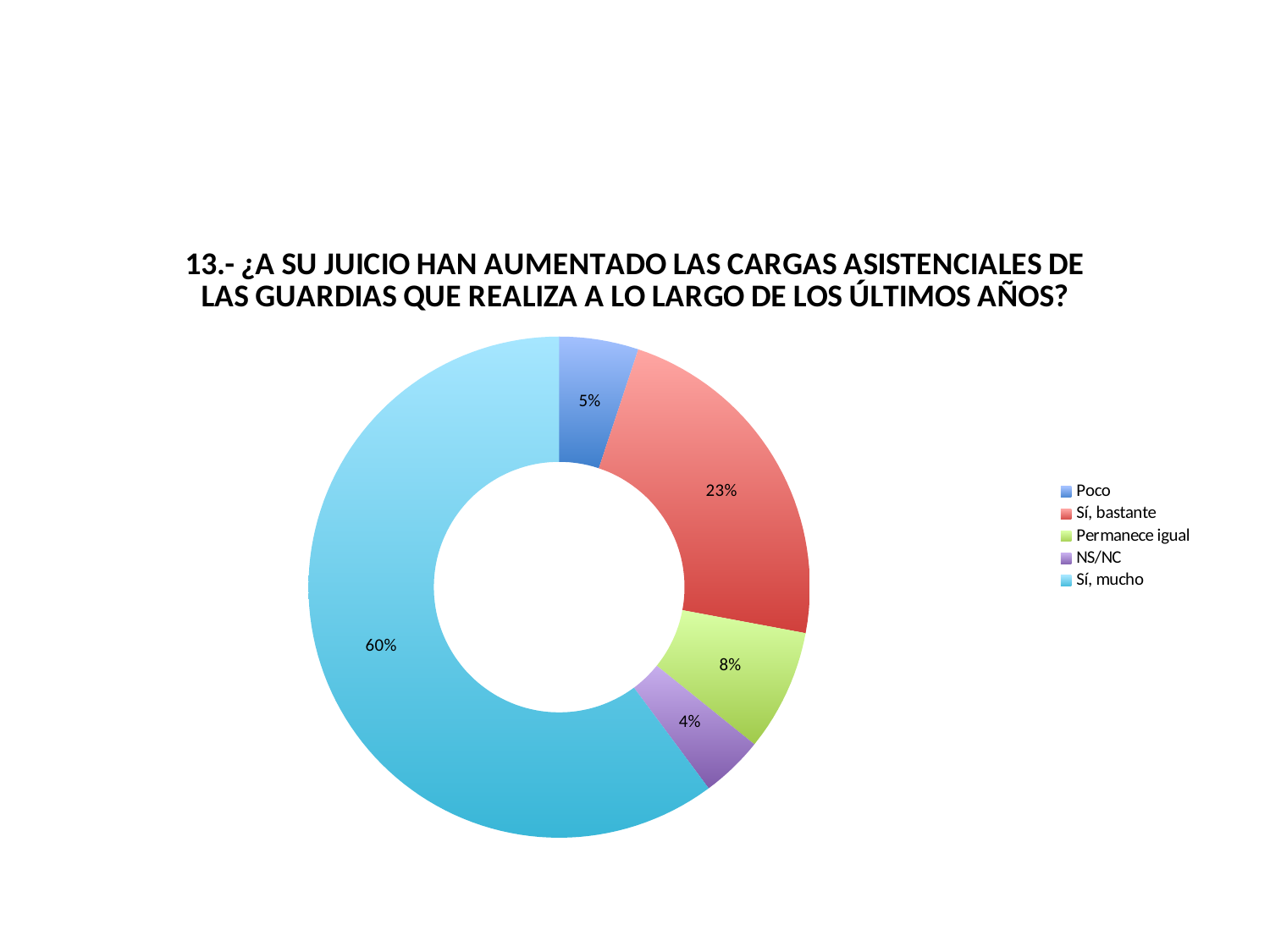
What percentage of respondents answered "Permanece igual"? 8% What percentage of respondents answered "NS/NC"? 4% Which response has the smallest share of the chart? NS/NC How many response categories does the legend list? 5 Which response has the largest share of the chart? Sí, mucho What percentage of respondents answered "Sí, mucho"? 60% Which is larger, the share for "Permanece igual" or the share for "Poco"? Permanece igual What colour represents "Sí, bastante" in the chart? Red What percentage of respondents answered "Poco"? 5% What is the difference in percentage points between "Sí, mucho" and "Sí, bastante"? 37 What kind of chart is shown on the slide? Doughnut (pie) chart What percentage of respondents answered "Sí, bastante"? 23%